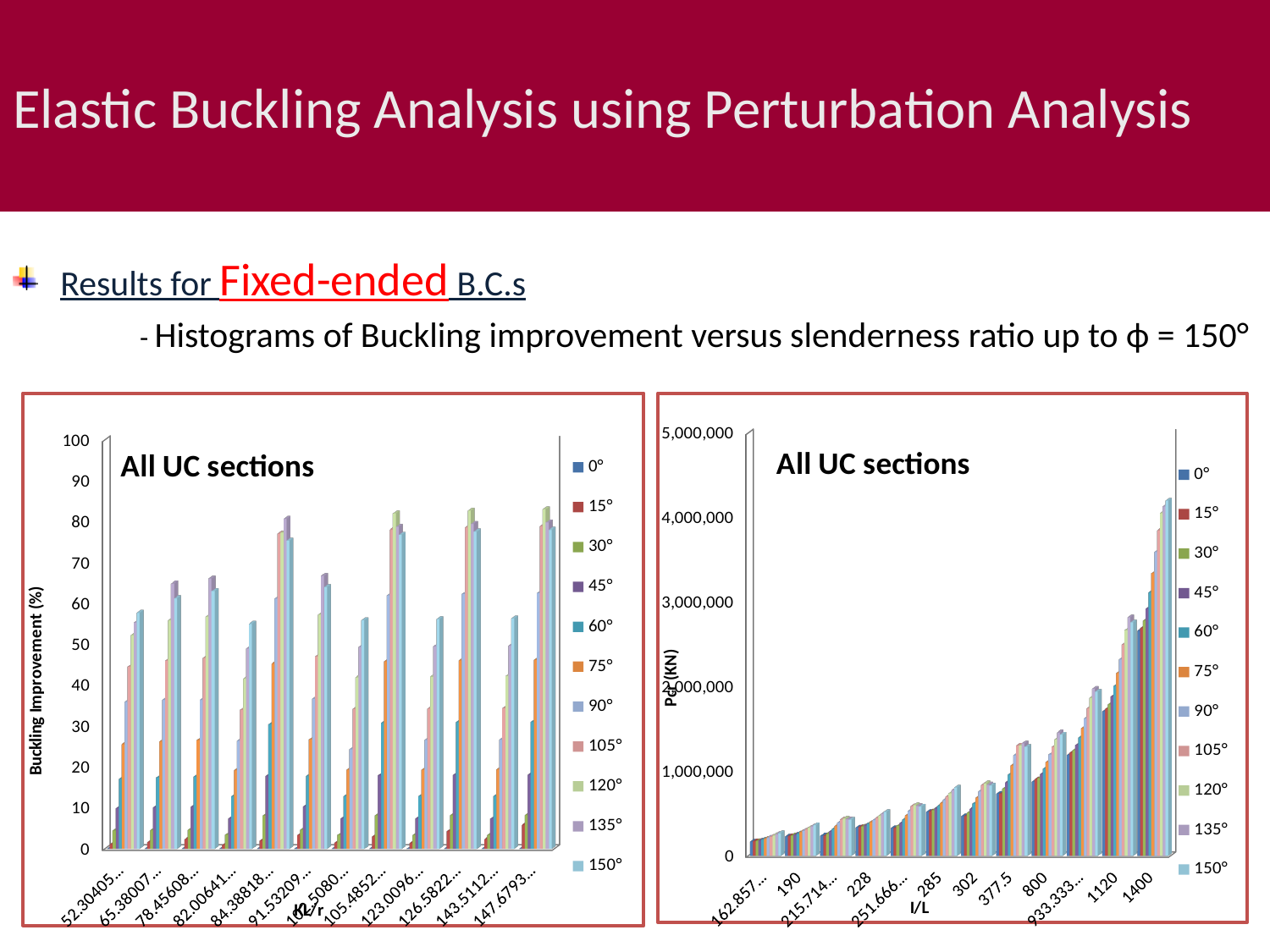
In the right chart, is the 150° value for I/L = 190 greater or less than 1,000,000? less In the right chart, which I/L category has the highest Pcr values? 1400 In the left chart, which is larger for the 150° series: the value at KL/r = 84.38818... or at KL/r = 52.30405...? 84.38818... What kind of chart is the left chart titled 'All UC sections'? bar chart How many series does the legend of the right chart (Pcr vs I/L) list? 11 In the right chart, is the 150° value for I/L = 1400 greater or less than 4,000,000? greater In the left chart, is the 0° value for KL/r = 84.38818... greater or less than 10? less In the left chart (Buckling improvement), how many KL/r categories are plotted along the x axis? 12 What is the y-axis title of the left chart? Buckling improvement (%) What is the x-axis title of the right chart? I/L In the right chart, do the Pcr values rise or fall as I/L increases along the x axis? rise